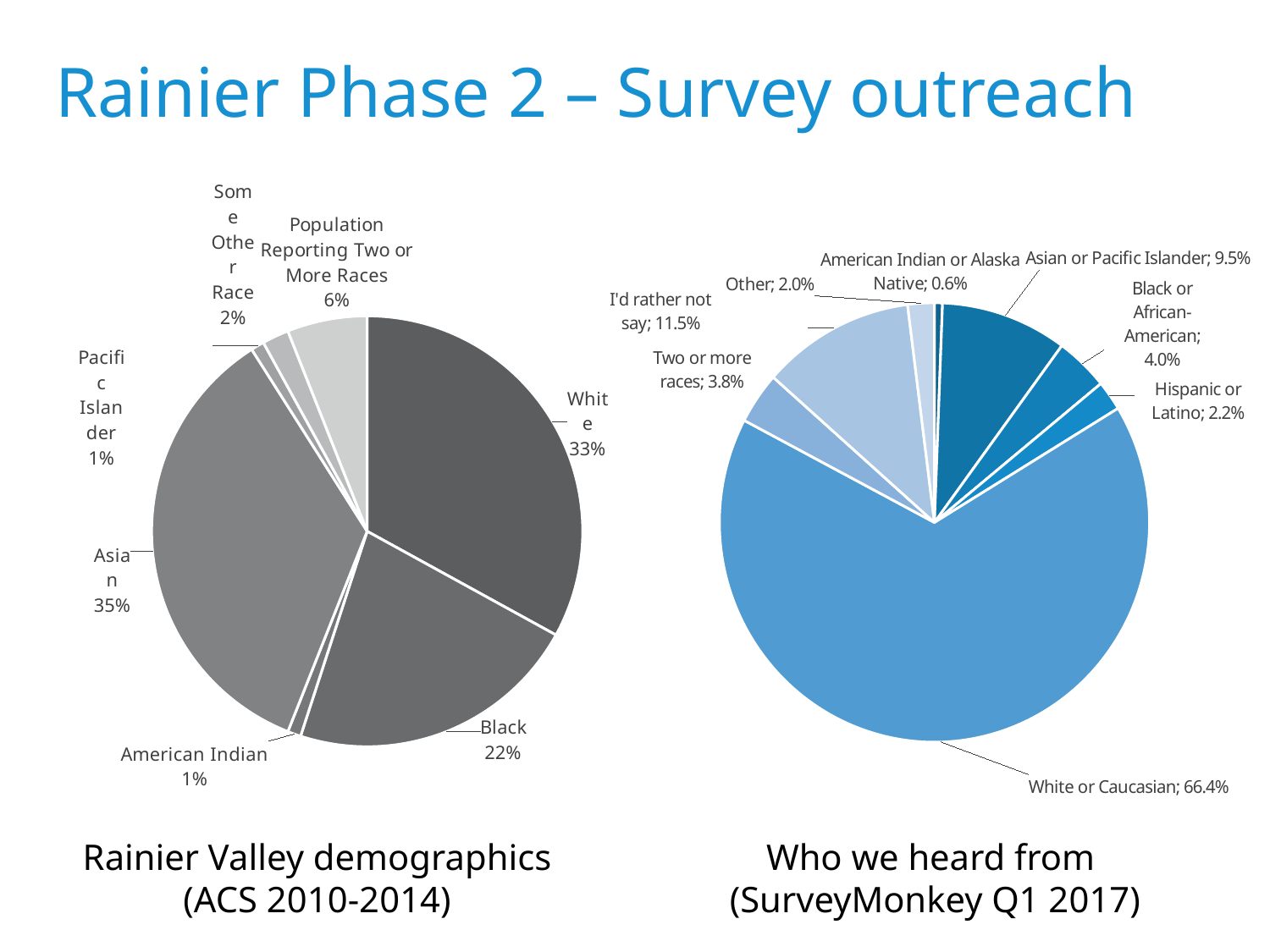
In the 'Who we heard from (SurveyMonkey Q1 2017)' pie chart, which is larger: Asian or Pacific Islander or Black or African-American? Asian or Pacific Islander In the 'Who we heard from (SurveyMonkey Q1 2017)' pie chart, what is the difference between the Hispanic or Latino and Other shares? 0.2% In the 'Rainier Valley demographics (ACS 2010-2014)' pie chart, what is the difference between the White and Black shares? 11% In the 'Who we heard from (SurveyMonkey Q1 2017)' pie chart, how many slices are labelled? 8 In the 'Rainier Valley demographics (ACS 2010-2014)' pie chart, what share is labelled for Asian? 35% In the 'Rainier Valley demographics (ACS 2010-2014)' pie chart, what share is labelled for Black? 22% In the 'Who we heard from (SurveyMonkey Q1 2017)' pie chart, what share is labelled for White or Caucasian? 66.4% In the 'Rainier Valley demographics (ACS 2010-2014)' pie chart, which category has the largest slice? Asian In the 'Rainier Valley demographics (ACS 2010-2014)' pie chart, how many slices are labelled? 7 What type of chart is used for 'Rainier Valley demographics (ACS 2010-2014)'? Pie chart In the 'Who we heard from (SurveyMonkey Q1 2017)' pie chart, what share is labelled for I'd rather not say? 11.5% In the 'Who we heard from (SurveyMonkey Q1 2017)' pie chart, which category has the smallest slice? American Indian or Alaska Native